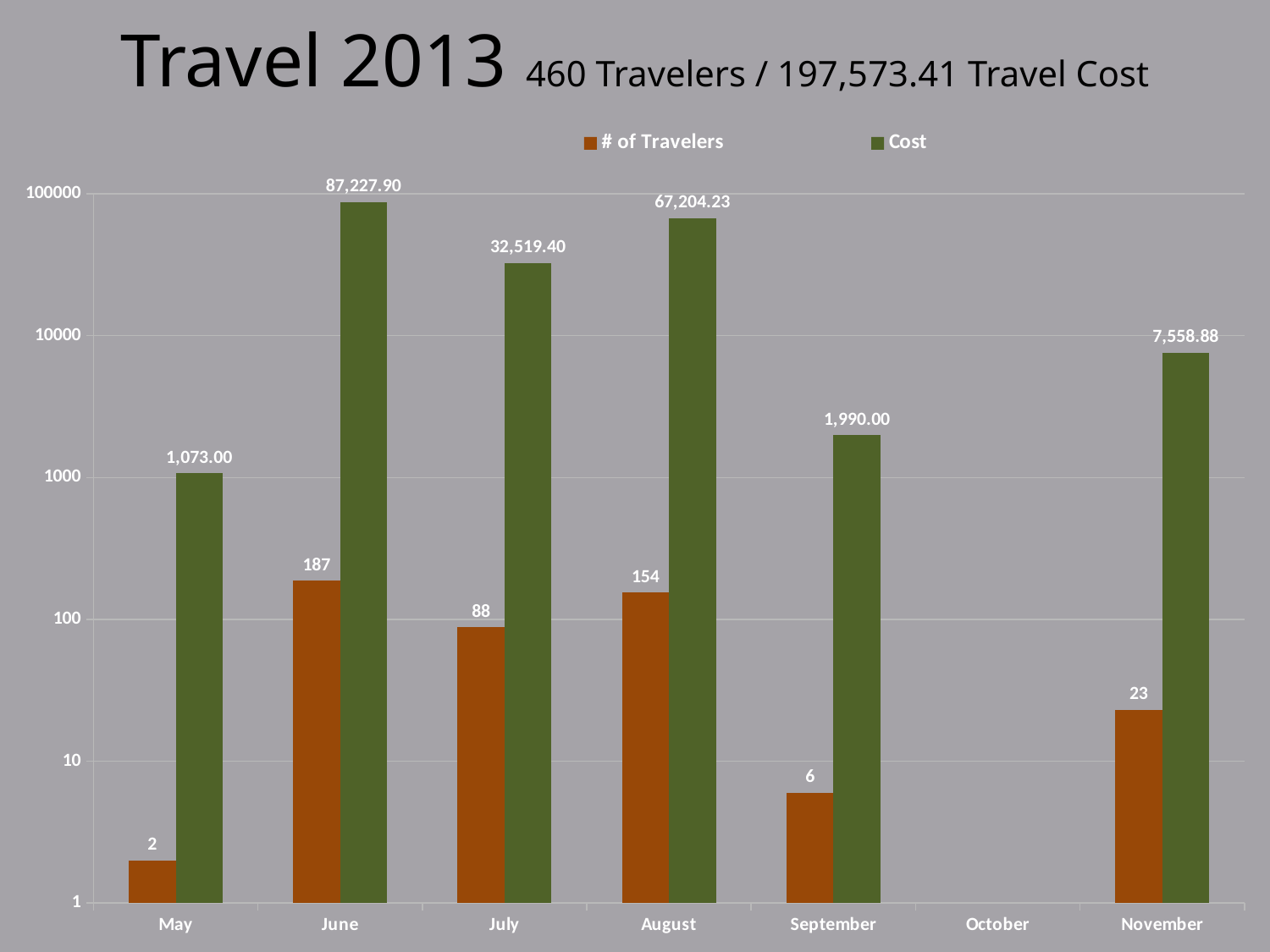
What is the difference in number of travelers between June and August? 33 What is the Cost for November? 7,558.88 What colour are the Cost bars? green Which month has the highest Cost? June What is the Cost for August? 67,204.23 Is the Cost for September greater or less than 1000? greater What is the number of travelers in June? 187 How many series does the legend list? 2 Is the Cost for July or the Cost for August larger? August How many months are shown on the x axis? 7 What kind of chart is shown on the slide? bar chart Which month with a plotted value has the lowest number of travelers? May